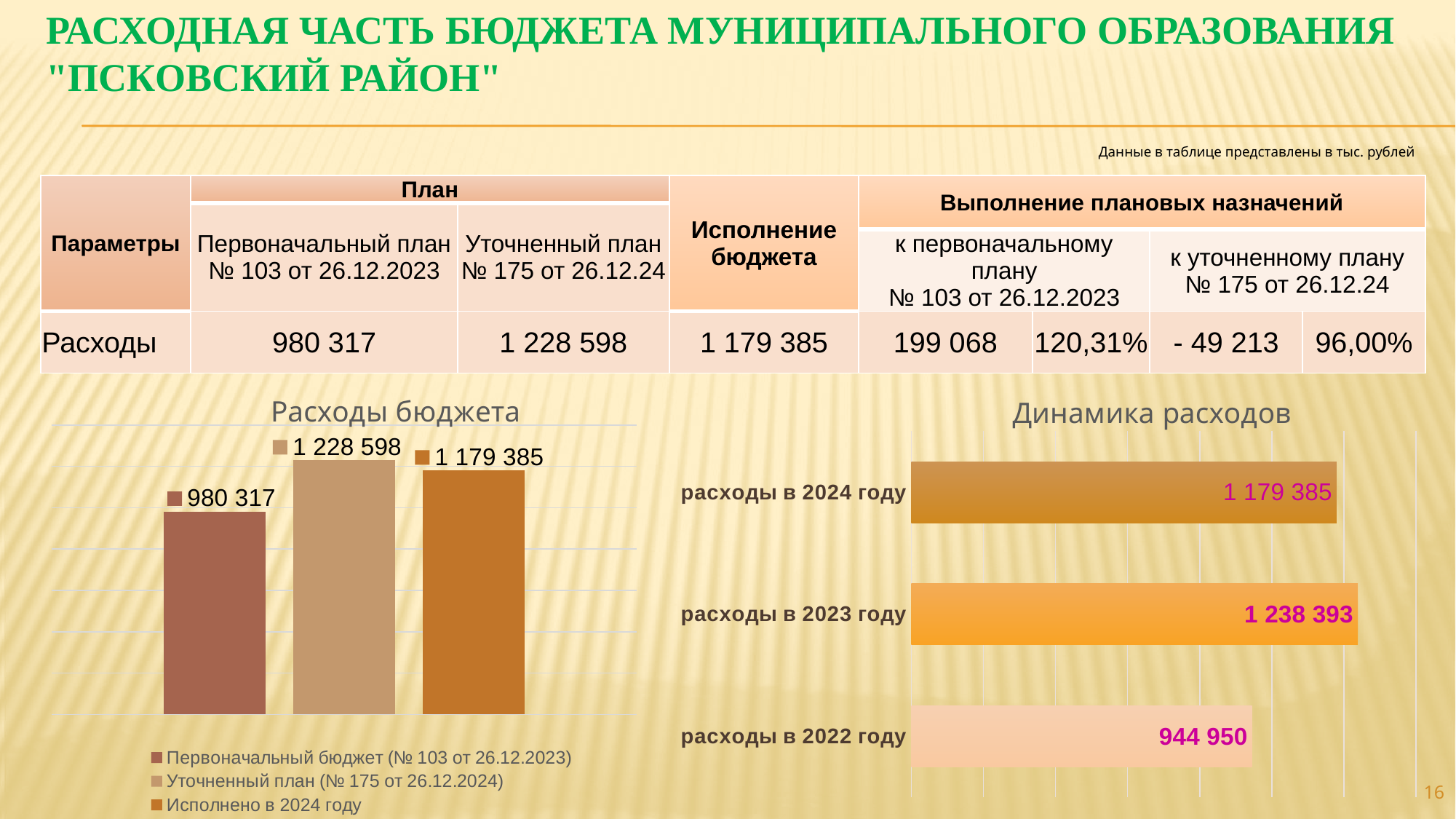
На диаграмме «Динамика расходов» в каком году расходы были наибольшими? расходы в 2023 году На диаграмме «Расходы бюджета» какая серия имеет наибольшее значение? Уточненный план (№ 175 от 26.12.2024) Какого типа диаграмма «Динамика расходов»? Столбчатая (горизонтальная) диаграмма На диаграмме «Динамика расходов» какое значение показано для категории «расходы в 2022 году»? 944 950 На диаграмме «Расходы бюджета» какое значение показано для серии «Исполнено в 2024 году»? 1 179 385 На диаграмме «Динамика расходов» на сколько расходы в 2023 году больше расходов в 2024 году? 59 008 На диаграмме «Расходы бюджета» какая серия имеет наименьшее значение? Первоначальный бюджет (№ 103 от 26.12.2023) Сколько категорий показано на диаграмме «Динамика расходов»? 3 На диаграмме «Динамика расходов» какое значение показано для категории «расходы в 2023 году»? 1 238 393 На диаграмме «Расходы бюджета» какое значение показано для серии «Первоначальный бюджет (№ 103 от 26.12.2023)»? 980 317 Сколько серий перечислено в легенде диаграммы «Расходы бюджета»? 3 На диаграмме «Расходы бюджета» на сколько уточненный план больше первоначального бюджета? 248 281